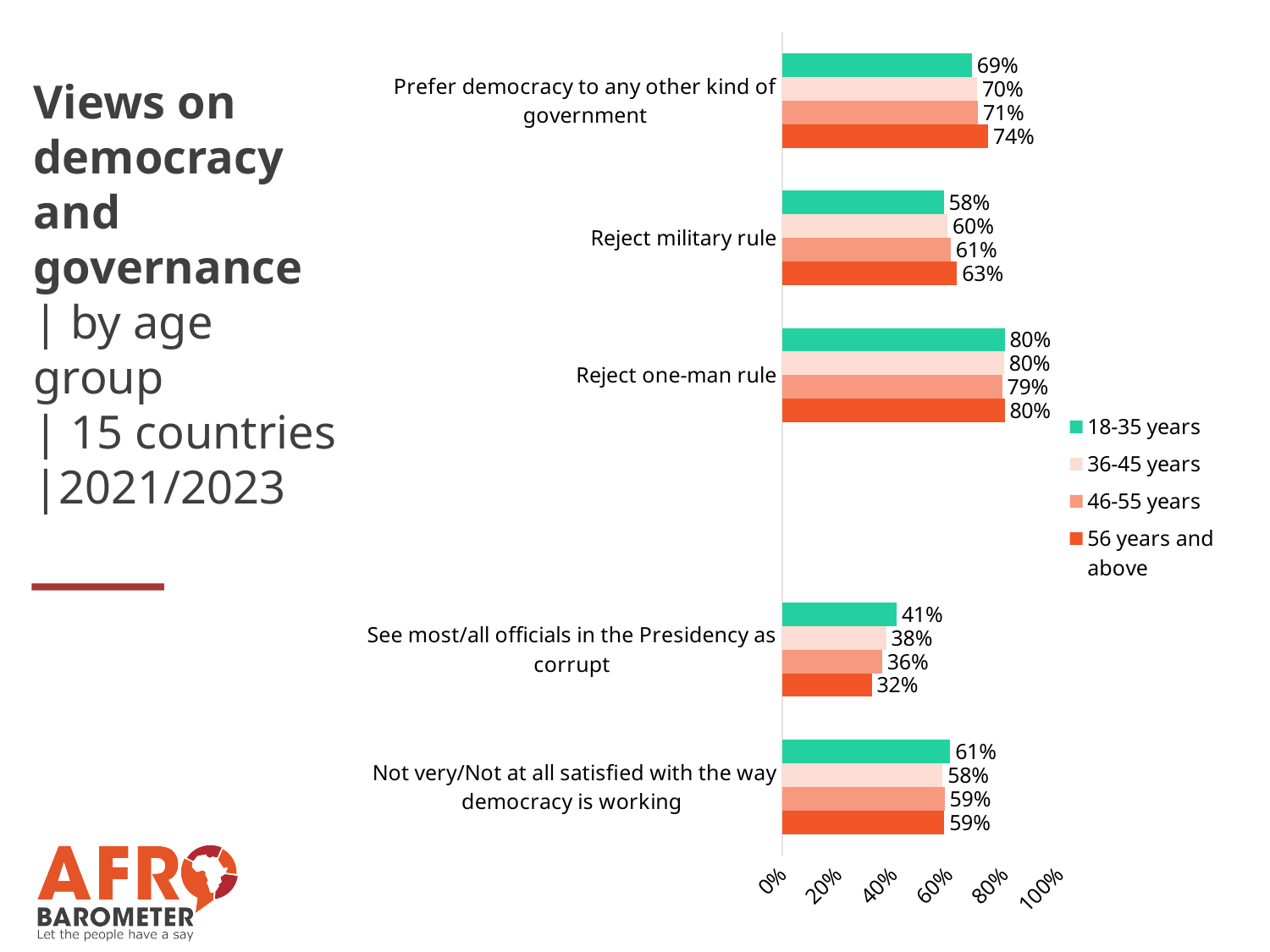
Which colour represents the 18-35 years age group in the legend? Green How many age groups does the legend list? 4 For 'Reject military rule', which is larger: the value for 18-35 years or for 56 years and above? 56 years and above What is the value for 56 years and above for 'Reject military rule'? 63% What percentage of 36-45 year olds see most/all officials in the Presidency as corrupt? 38% What is the value for 46-55 years for 'Not very/Not at all satisfied with the way democracy is working'? 59% What percentage of 18-35 year olds prefer democracy to any other kind of government? 69% What kind of chart is shown on the slide? Bar chart Which age group has the lowest value for 'See most/all officials in the Presidency as corrupt'? 56 years and above How many statement categories are plotted on the chart? 5 Which age group has the highest value for 'Prefer democracy to any other kind of government'? 56 years and above What is the difference between the 18-35 years and 56 years and above values for 'See most/all officials in the Presidency as corrupt'? 9 percentage points